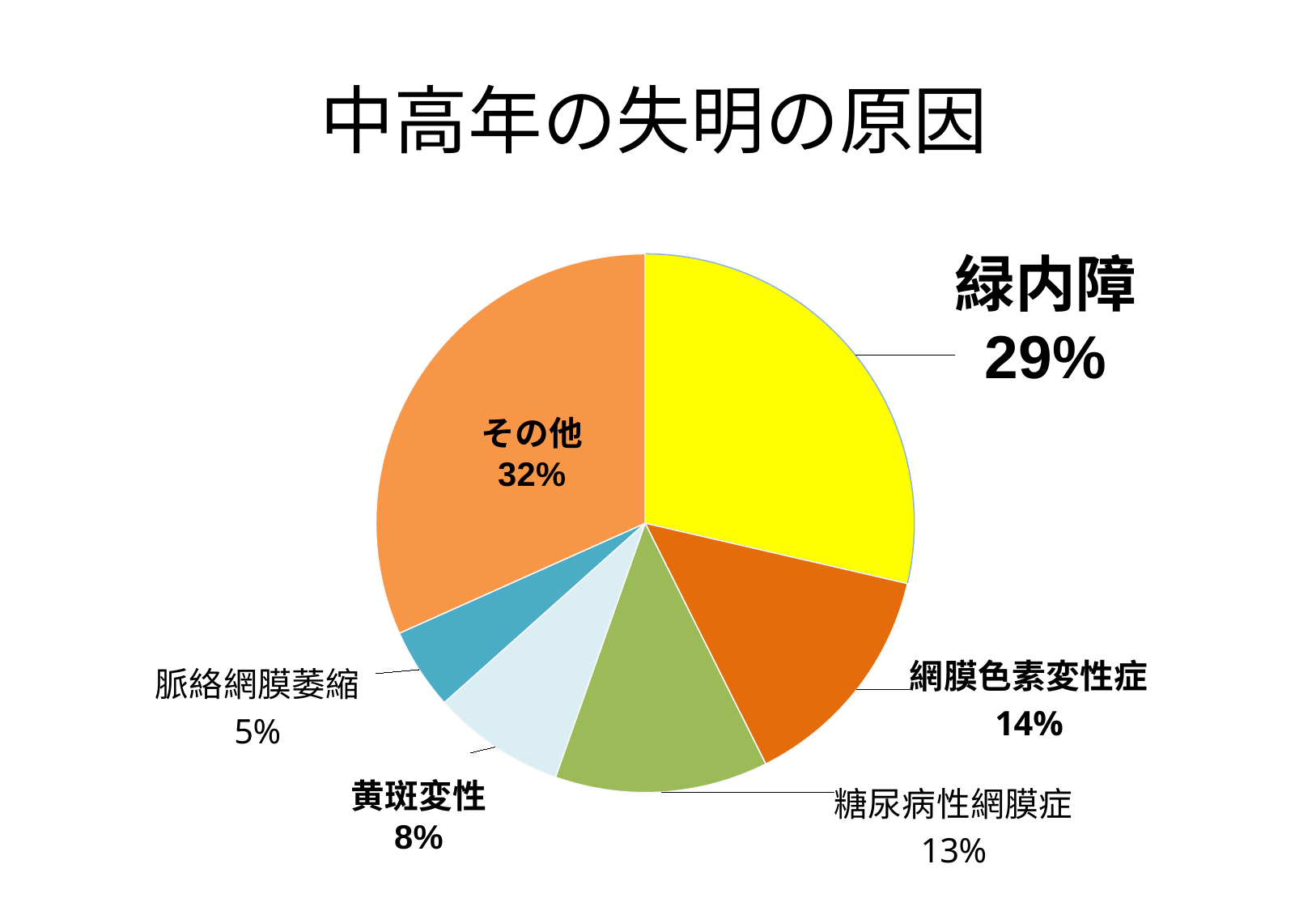
What is the value shown for 黄斑変性? 8% Which is larger, the share for 黄斑変性 or the share for 糖尿病性網膜症? 糖尿病性網膜症 What is the difference between the shares of 緑内障 and 網膜色素変性症? 15% What type of chart is shown on the slide? pie chart What is the value shown for 糖尿病性網膜症? 13% What share of the pie does 緑内障 account for? 29% How many slices does the pie chart have? 6 What is the value shown for 網膜色素変性症? 14% Which category has the largest slice of the pie? その他 Which category has the smallest slice of the pie? 脈絡網膜萎縮 What is the title of the chart? 中高年の失明の原因 What is the value shown for 脈絡網膜萎縮? 5%